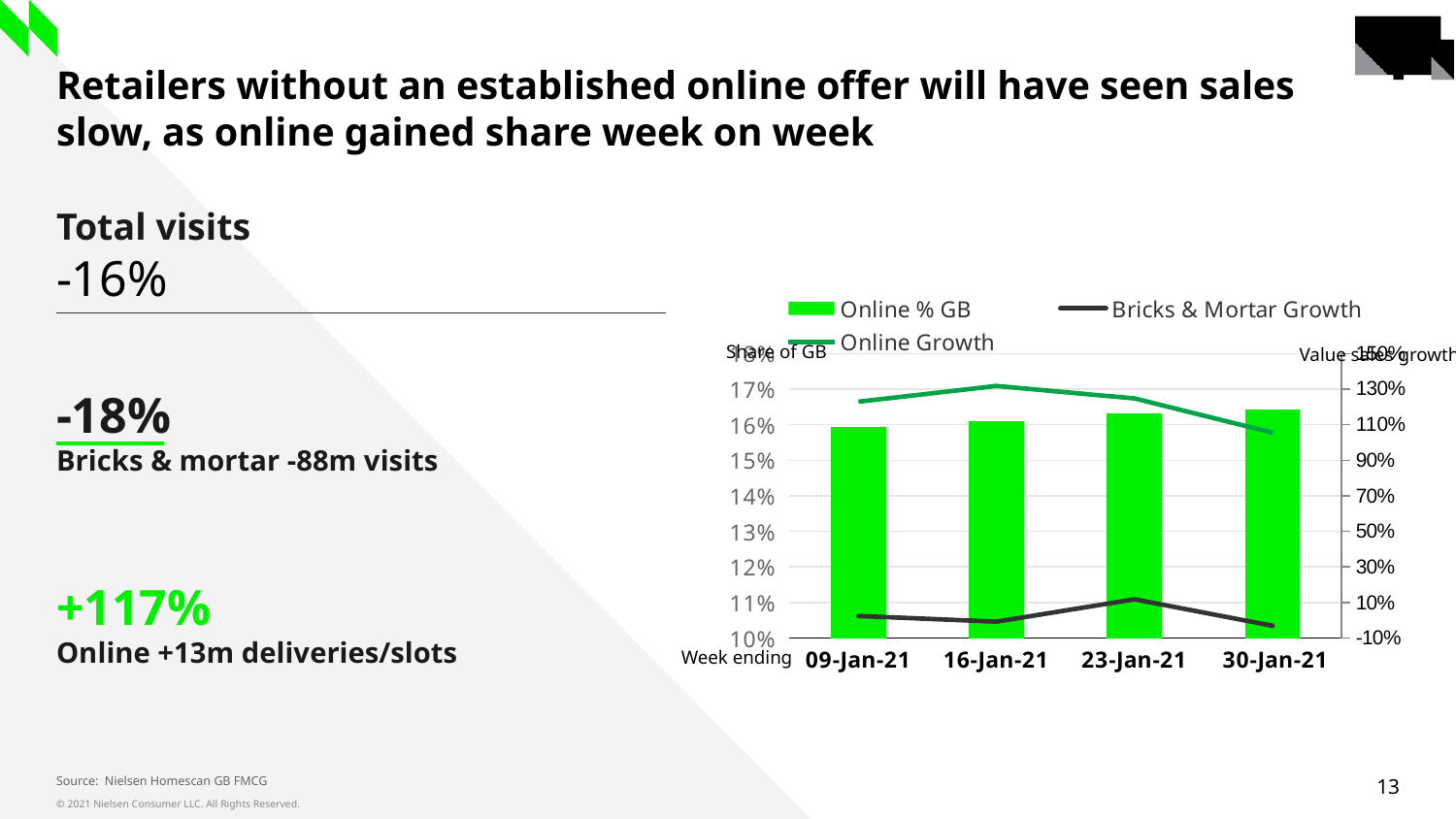
Is the Bricks & Mortar Growth value for 09-Jan-21 greater or less than 10%? less What kind of chart is shown on the slide? Combined bar and line chart Is the Online Growth value for 09-Jan-21 greater or less than 110%? greater Do the Online % GB bars rise or fall from 09-Jan-21 to 30-Jan-21? Rise In which week does the Online Growth line reach its highest point? 16-Jan-21 How many weeks (categories) are shown on the x axis of the chart? 4 In which week does the Online Growth line reach its lowest point? 30-Jan-21 Which series is plotted as bars in the chart? Online % GB What is the title of the right-hand vertical axis of the chart? Value sales growth Which week has the lowest Online % GB bar? 09-Jan-21 How many series does the chart legend list? 3 In which week does the Bricks & Mortar Growth line reach its highest point? 23-Jan-21